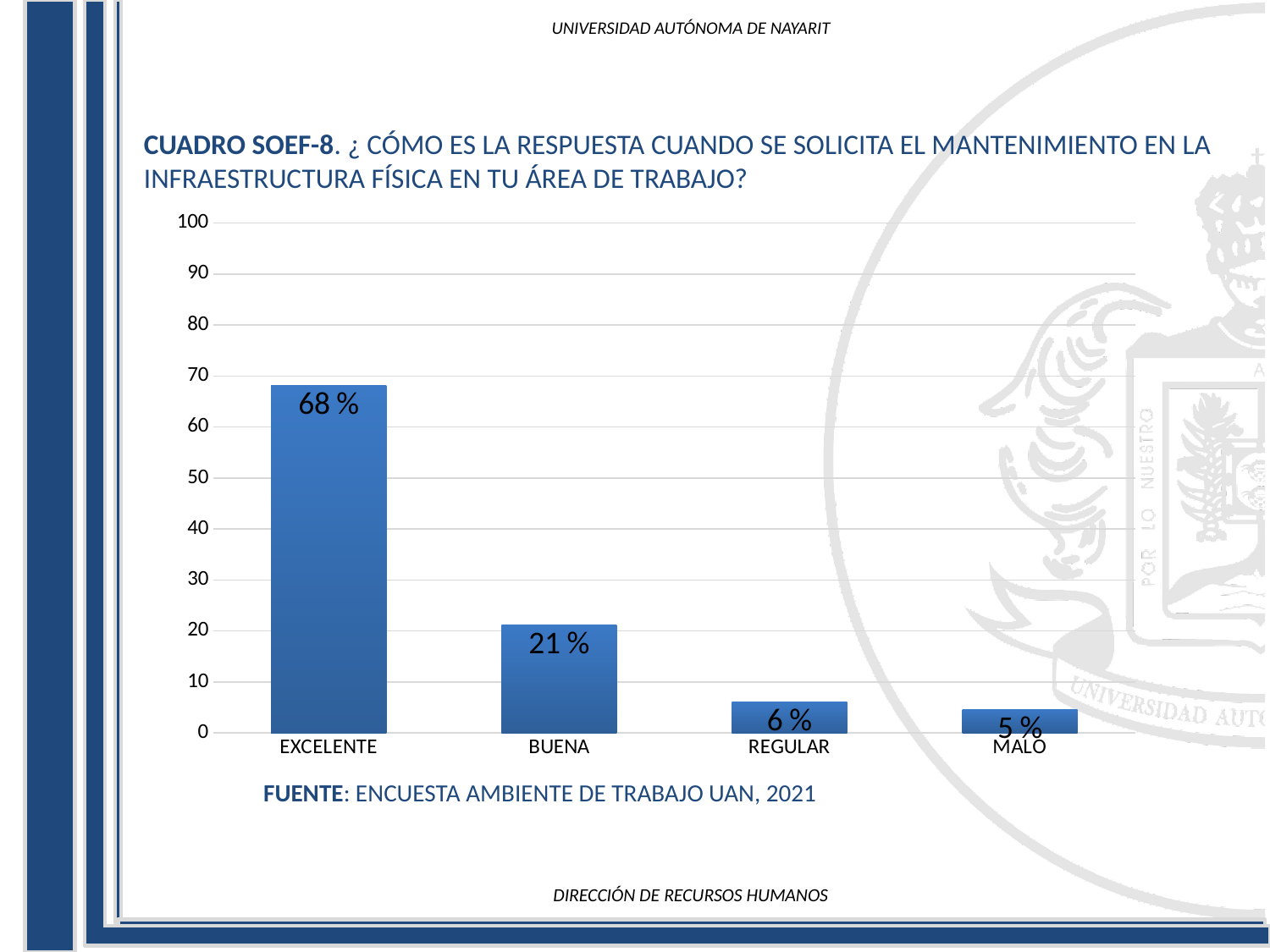
Is the value for EXCELENTE greater or less than 60? greater Which category has the lowest value? MALO What source is cited below the chart? ENCUESTA AMBIENTE DE TRABAJO UAN, 2021 What is the difference between the values for EXCELENTE and BUENA? 47 % What kind of chart is shown on the slide? bar chart What is the value for MALO? 5 % Which category has the highest value? EXCELENTE Which is larger, the value for BUENA or the value for REGULAR? BUENA How many categories are shown on the x axis? 4 What is the value for BUENA? 21 % What is the value for REGULAR? 6 % What is the value for EXCELENTE? 68 %